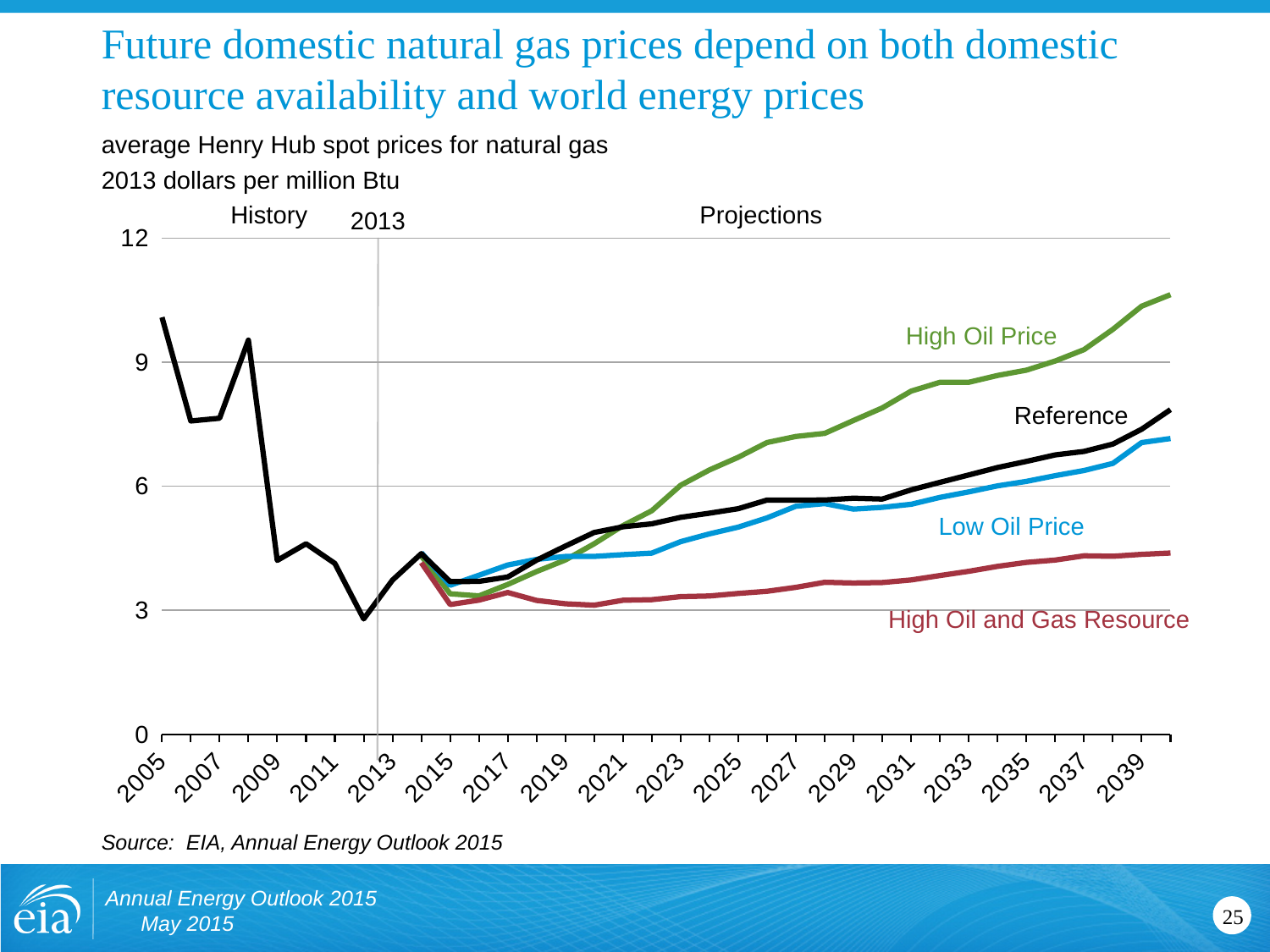
Is the historical value in 2005 greater or less than 9? greater Does the High Oil Price line rise or fall between 2020 and 2040? rise How many series (scenarios) are plotted on the chart? 4 Is the Reference value in 2040 greater or less than 6? greater What units are the prices on the chart expressed in? 2013 dollars per million Btu Which year does the vertical line separating History from Projections mark? 2013 In 2035, which is higher: the High Oil Price line or the High Oil and Gas Resource line? High Oil Price Is the High Oil and Gas Resource value in 2040 greater or less than 6? less What kind of chart is shown on the slide? line chart Which scenario has the highest natural gas price in 2040? High Oil Price Which scenario has the lowest natural gas price in 2040? High Oil and Gas Resource